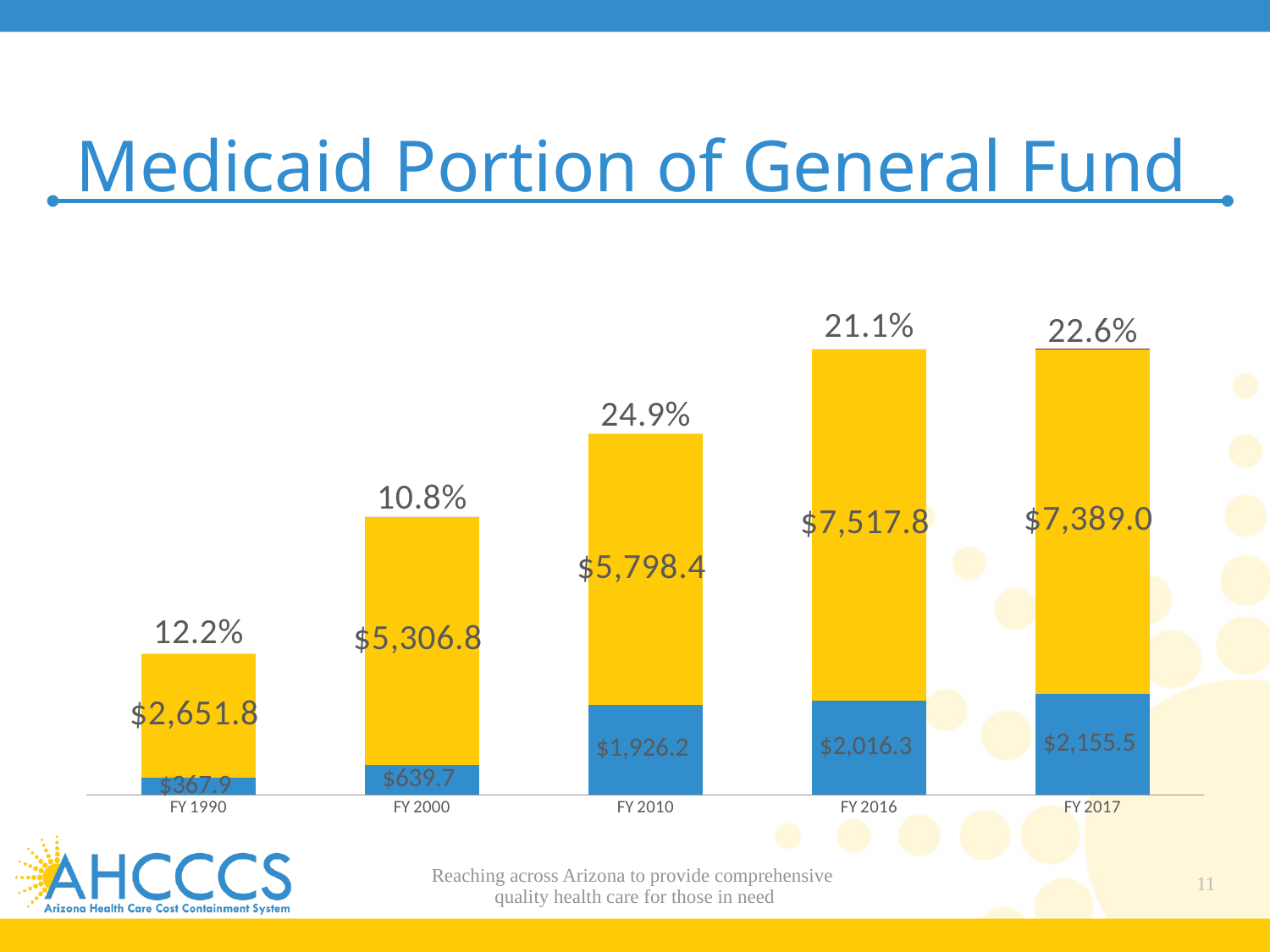
What is the value of the yellow segment for FY 2010? $5,798.4 How many fiscal years are shown on the x axis of the chart? 5 Which fiscal year has the lowest percentage label above its bar? FY 2000 Which fiscal year has the highest percentage label above its bar? FY 2010 Which fiscal year has the largest blue segment value? FY 2017 What is the total of the FY 1990 stacked bar (blue plus yellow segments)? $3,019.7 Is the yellow segment value larger for FY 2016 or FY 2017? FY 2016 Do the blue segment values rise or fall from FY 1990 to FY 2017? Rise What is the difference between the yellow segment values for FY 2000 and FY 1990? $2,655.0 What is the value of the blue segment for FY 1990? $367.9 What percentage is shown above the FY 2017 bar? 22.6% What type of chart is shown on the slide? Stacked bar chart